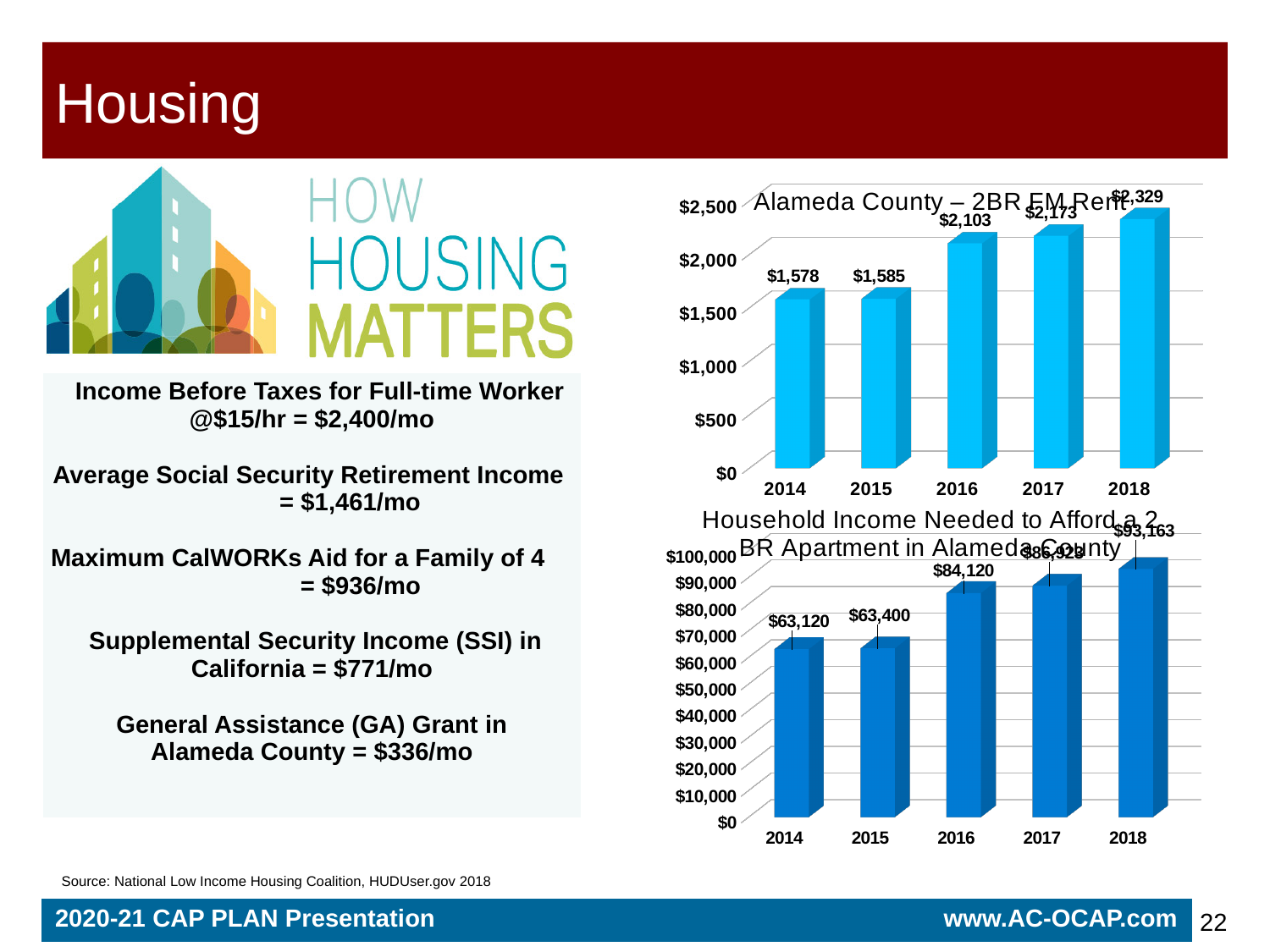
In the 'Household Income Needed to Afford a 2 BR Apartment in Alameda County' chart, is the value for 2016 greater or less than $80,000? greater What kind of chart is the 'Alameda County – 2BR FM Rent' chart? bar chart In the 'Household Income Needed to Afford a 2 BR Apartment in Alameda County' chart, which year has the lowest value? 2014 In the 'Household Income Needed to Afford a 2 BR Apartment in Alameda County' chart, what is the value for 2018? $93,163 In the 'Household Income Needed to Afford a 2 BR Apartment in Alameda County' chart, what is the value for 2015? $63,400 In the 'Alameda County – 2BR FM Rent' chart, do the values rise or fall from 2014 to 2018? rise In the 'Alameda County – 2BR FM Rent' chart, what is the difference between the 2018 and 2014 values? $751 In the 'Alameda County – 2BR FM Rent' chart, what is the value for 2016? $2,103 In the 'Alameda County – 2BR FM Rent' chart, what is the value for 2014? $1,578 In the 'Alameda County – 2BR FM Rent' chart, how many years are plotted? 5 In the 'Household Income Needed to Afford a 2 BR Apartment in Alameda County' chart, what is the difference between the 2016 and 2014 values? $21,000 In the 'Alameda County – 2BR FM Rent' chart, which year has the highest rent? 2018